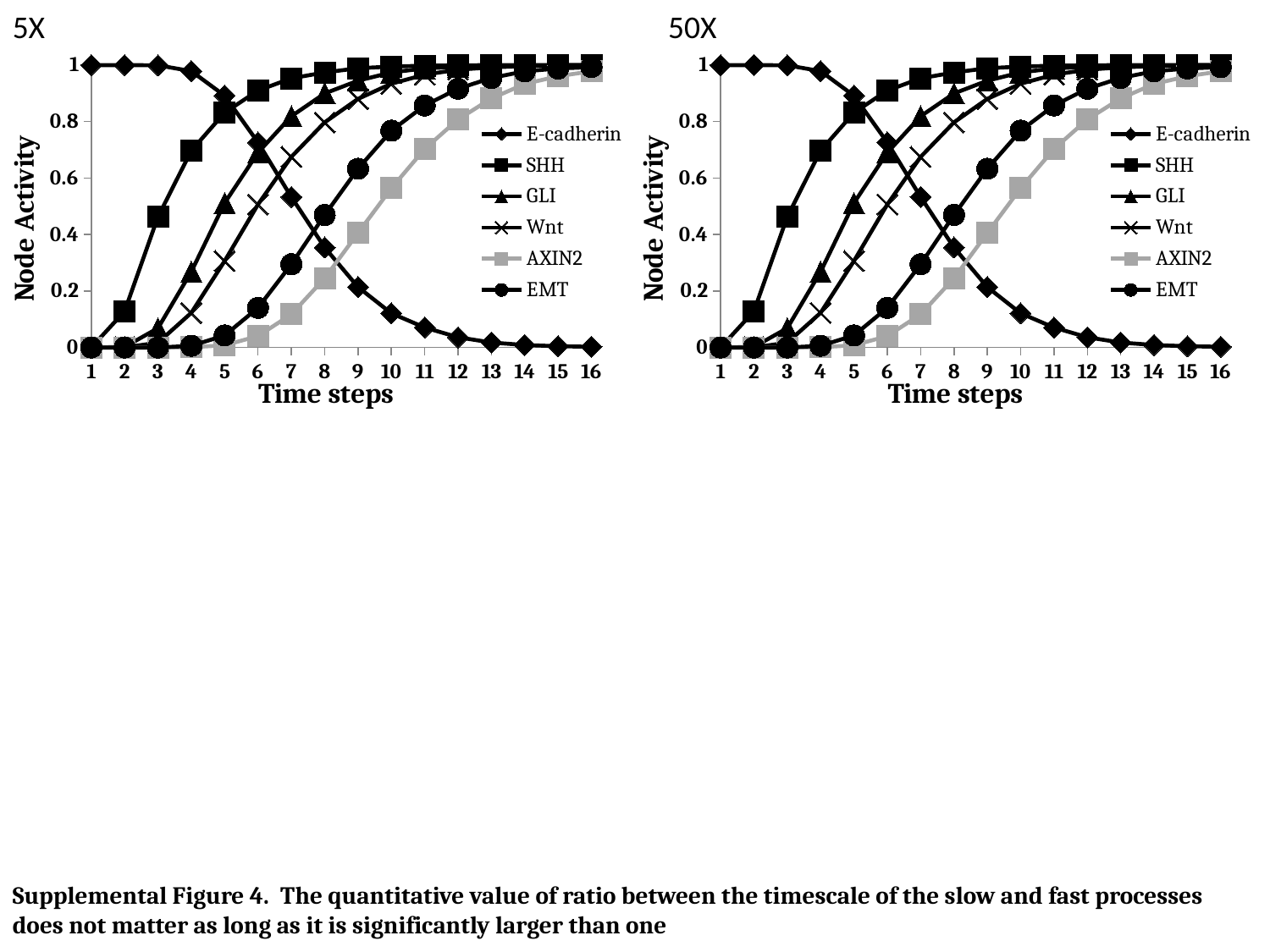
In the 50X chart, is the value for E-cadherin at time step 12 greater or less than 0.2? less How many time steps are shown on the x axis of the 5X chart? 16 In the 50X chart, is the value for AXIN2 at time step 10 greater or less than 0.4? greater How many series does the legend of the 50X chart list? 6 What is the x-axis title of the 5X chart? Time steps What is the y-axis title of the 50X chart? Node Activity In the 5X chart, does E-cadherin rise or fall as the time steps increase? fall What kind of chart is the 5X chart on the left? line chart In the 5X chart, which is larger at time step 6, SHH or EMT? SHH In the 5X chart, is the value for SHH at time step 4 greater or less than 0.6? greater In the 50X chart, which is larger at time step 10, EMT or AXIN2? EMT In the 50X chart, does SHH rise or fall as the time steps increase? rise